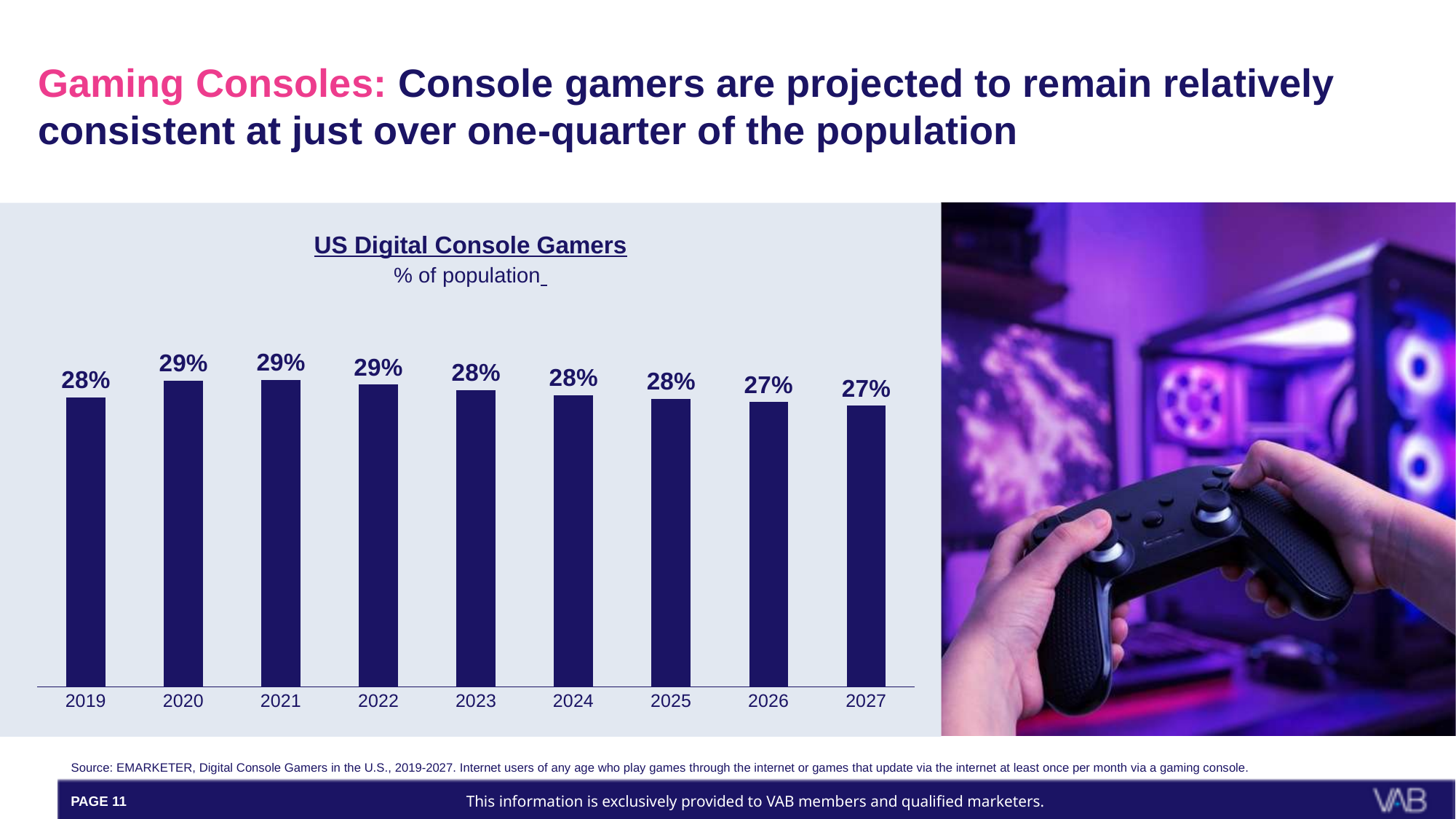
What is the lowest value shown in the chart? 27% What is the value shown for 2022? 29% Which year has the larger value, 2020 or 2027? 2020 What is the title of the chart? US Digital Console Gamers What is the value for 2019 in the US Digital Console Gamers chart? 28% What percentage of the population is projected to be digital console gamers in 2027? 27% Do the values generally rise or fall from 2022 to 2027? Fall What kind of chart is used to show US Digital Console Gamers? Bar chart What is the difference between the values for 2021 and 2027? 2 percentage points What is the highest value shown in the chart? 29% How many years are shown on the x axis of the chart? 9 What is the value shown for 2025? 28%